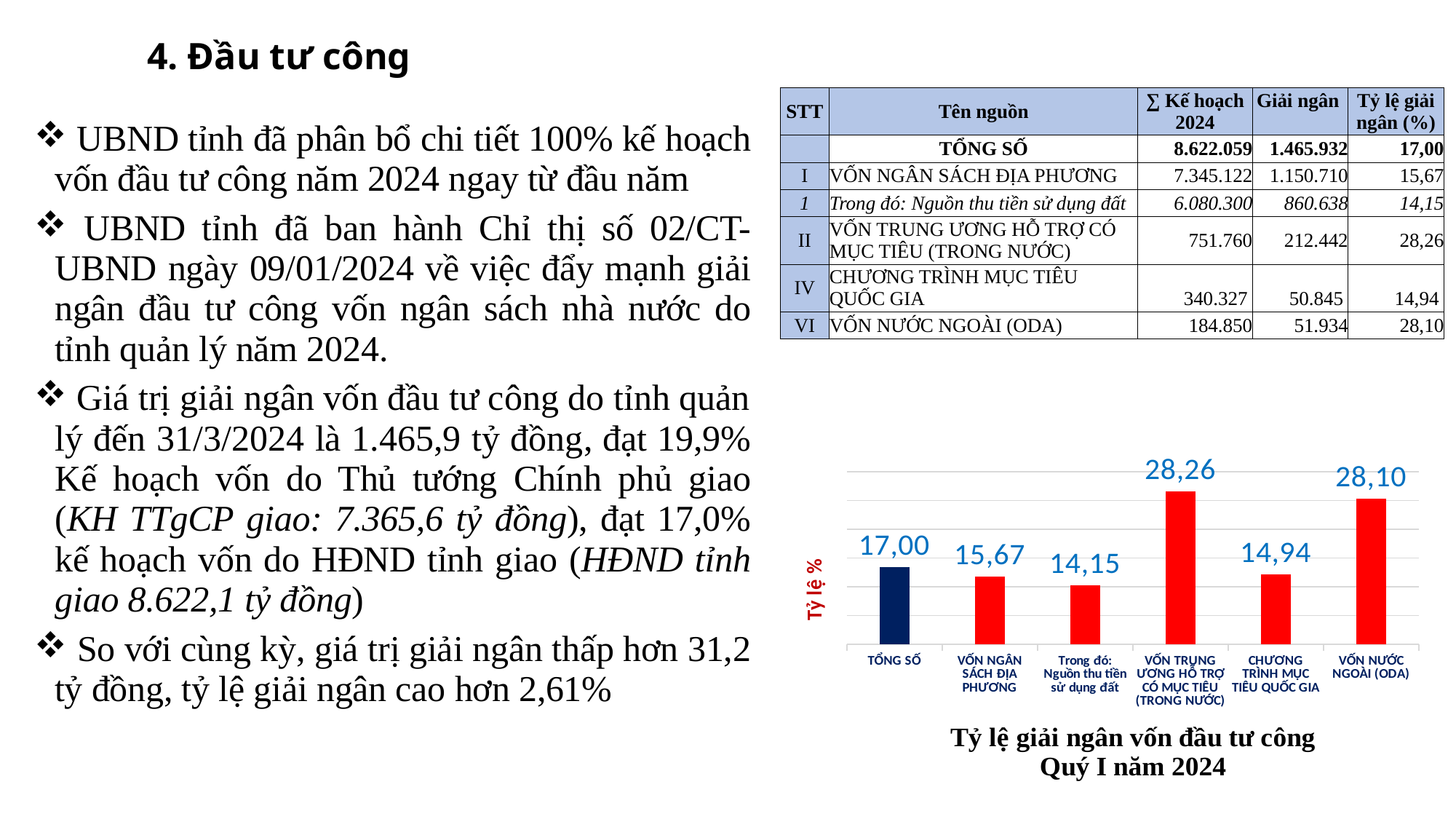
Which category has the highest value in the chart? VỐN TRUNG ƯƠNG HỖ TRỢ CÓ MỤC TIÊU (TRONG NƯỚC) Which category has the lowest value in the chart? Trong đó: Nguồn thu tiền sử dụng đất What is the value for VỐN NƯỚC NGOÀI (ODA) in the chart? 28,10 How many categories are shown in the chart? 6 What is the label on the vertical axis of the chart? Tỷ lệ % What is the value for VỐN NGÂN SÁCH ĐỊA PHƯƠNG in the chart? 15,67 What is the difference between the values for VỐN TRUNG ƯƠNG HỖ TRỢ CÓ MỤC TIÊU (TRONG NƯỚC) and TỔNG SỐ? 11,26 What type of chart is shown on the slide? bar chart Which is larger in the chart: the value for VỐN NGÂN SÁCH ĐỊA PHƯƠNG or the value for CHƯƠNG TRÌNH MỤC TIÊU QUỐC GIA? VỐN NGÂN SÁCH ĐỊA PHƯƠNG What is the title of the chart? Tỷ lệ giải ngân vốn đầu tư công Quý I năm 2024 What is the value for TỔNG SỐ in the chart? 17,00 What is the value for CHƯƠNG TRÌNH MỤC TIÊU QUỐC GIA in the chart? 14,94